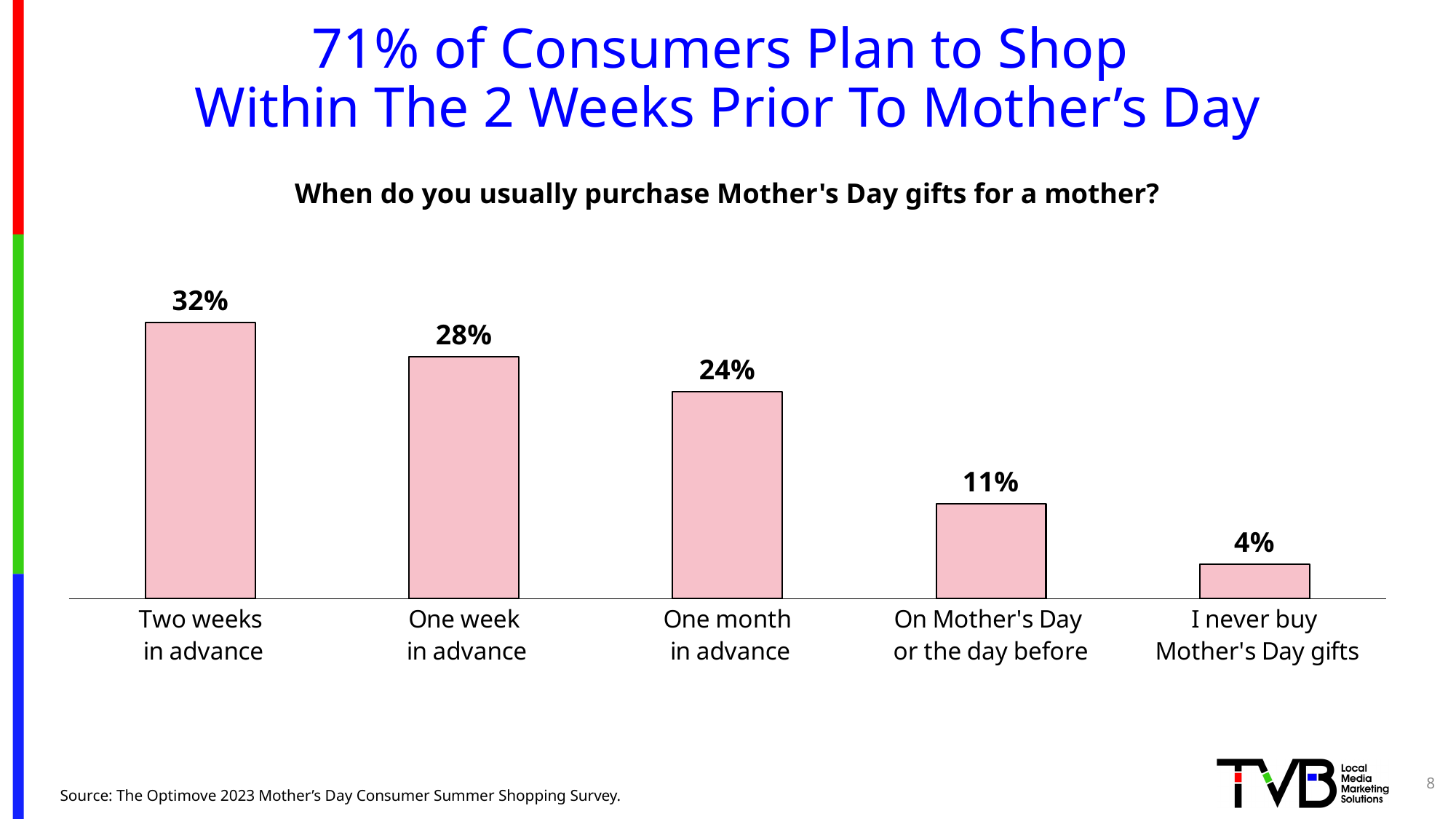
What type of chart is shown on the slide? Bar chart Do the values rise or fall moving from left to right across the categories? Fall How many categories are shown in the chart? 5 What question does the chart title ask? When do you usually purchase Mother's Day gifts for a mother? What percentage of respondents say they never buy Mother's Day gifts? 4% Which is larger: the percentage for 'One week in advance' or 'One month in advance'? One week in advance What percentage of respondents purchase Mother's Day gifts on Mother's Day or the day before? 11% Which purchase timing category has the highest percentage? Two weeks in advance What is the combined percentage for 'Two weeks in advance' and 'One week in advance'? 60% Which category has the lowest percentage? I never buy Mother's Day gifts What percentage of respondents usually purchase Mother's Day gifts two weeks in advance? 32% What is the difference in percentage points between 'Two weeks in advance' and 'One month in advance'? 8